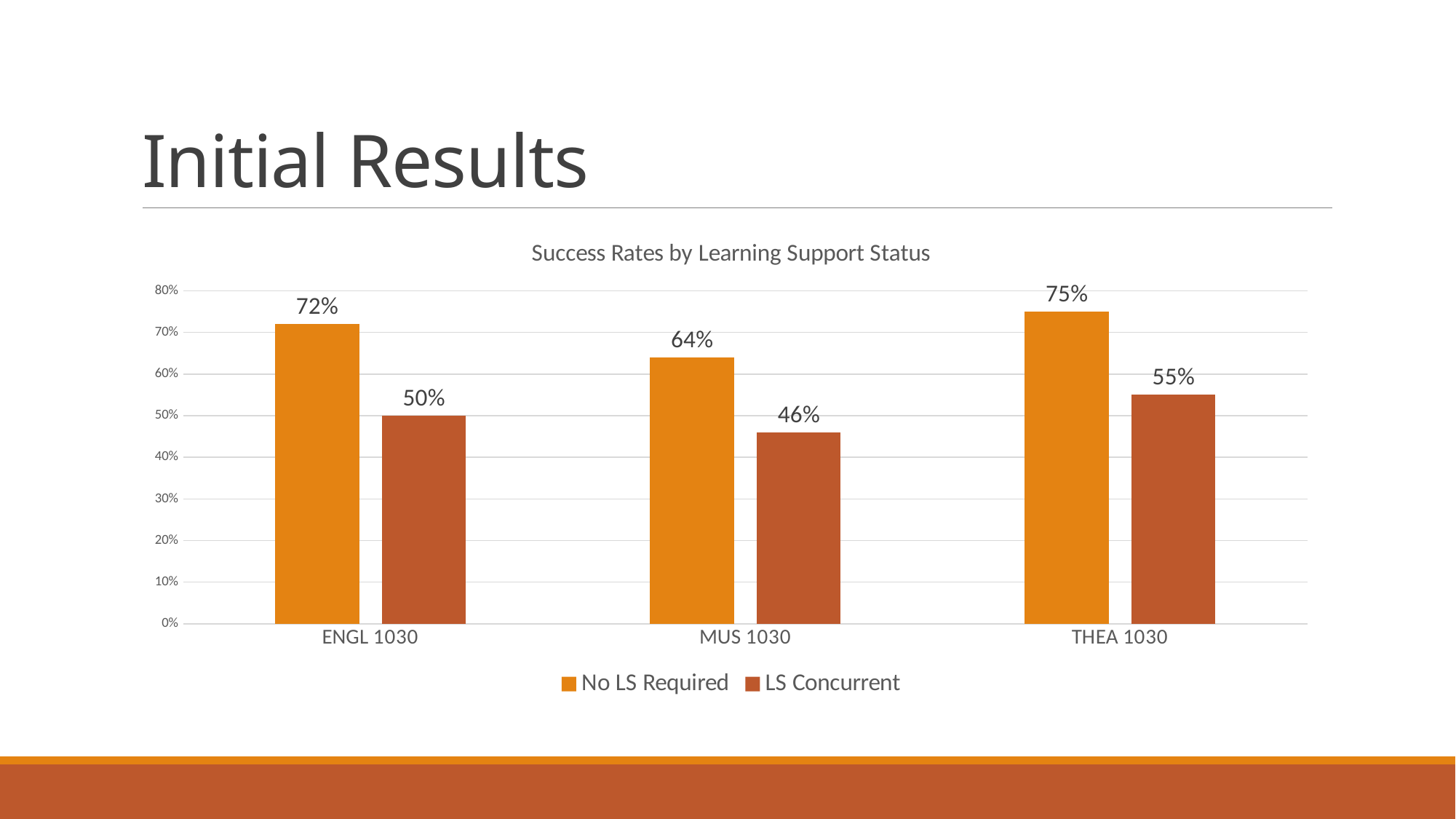
Which is higher in MUS 1030: the No LS Required rate or the LS Concurrent rate? No LS Required How many series does the chart legend list? 2 What is the success rate for LS Concurrent students in THEA 1030? 55% Is the LS Concurrent success rate for THEA 1030 greater or less than 60%? less How many courses are shown on the x axis of the chart? 3 What is the title of the chart? Success Rates by Learning Support Status What type of chart is shown on the slide? Bar chart What is the difference between the No LS Required and LS Concurrent success rates in ENGL 1030? 22% Which course has the highest success rate for No LS Required students? THEA 1030 Which course has the lowest success rate for LS Concurrent students? MUS 1030 What is the success rate for LS Concurrent students in MUS 1030? 46% What is the success rate for No LS Required students in ENGL 1030? 72%